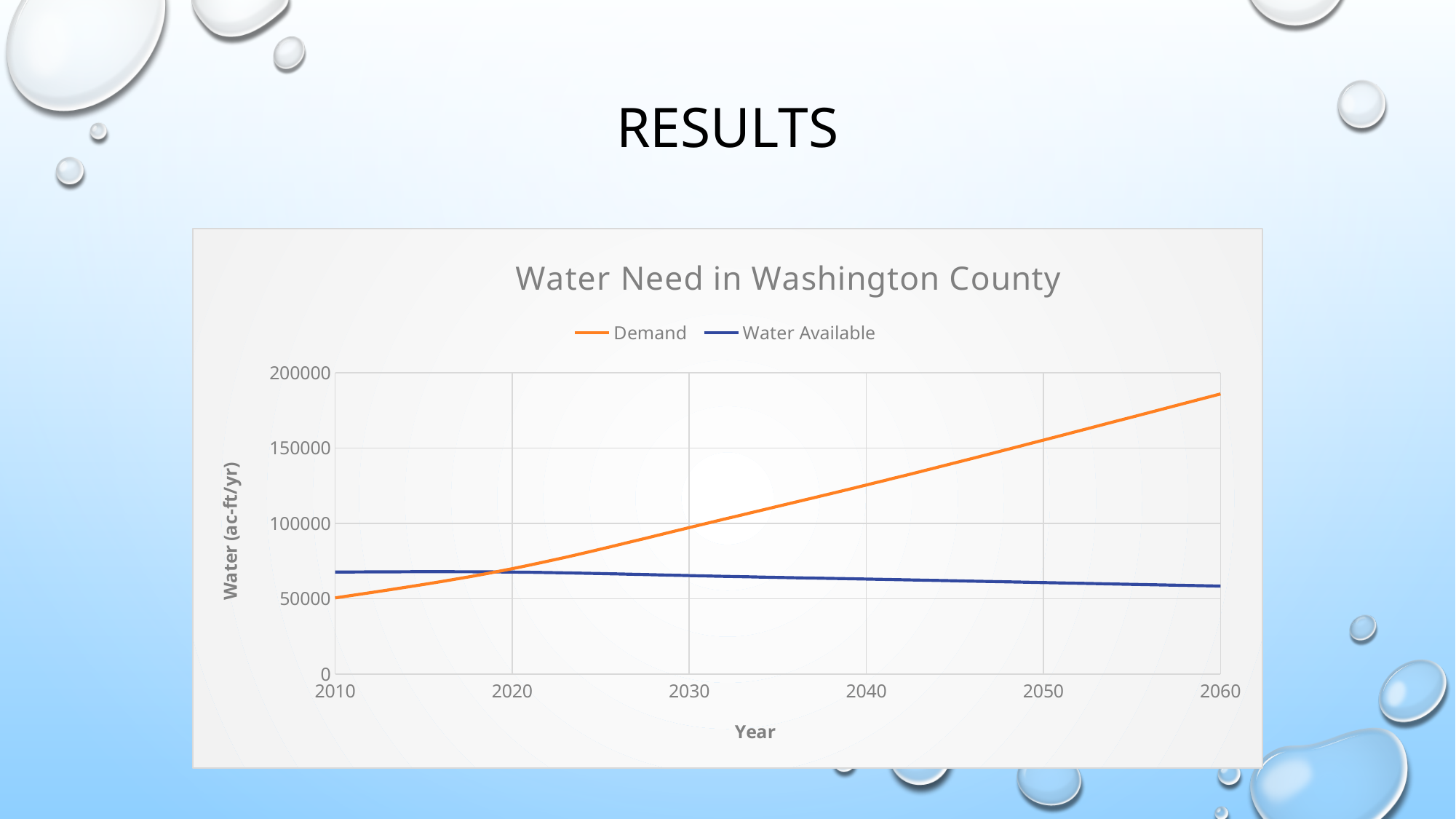
Does the Demand line rise or fall from 2010 to 2060? Rises Is the value for Water Available in 2010 greater or less than 50000? greater Is the value for Water Available in 2050 greater or less than 100000? less What kind of chart is shown on the slide? Line chart Does the Water Available line rise or fall from 2010 to 2060? Falls In 2060, which series has the larger value, Demand or Water Available? Demand What is the title of the chart? Water Need in Washington County In 2010, which series has the larger value, Demand or Water Available? Water Available Is the value for Demand in 2060 greater or less than 150000? greater How many series does the legend list? 2 What is the label on the vertical axis? Water (ac-ft/yr)